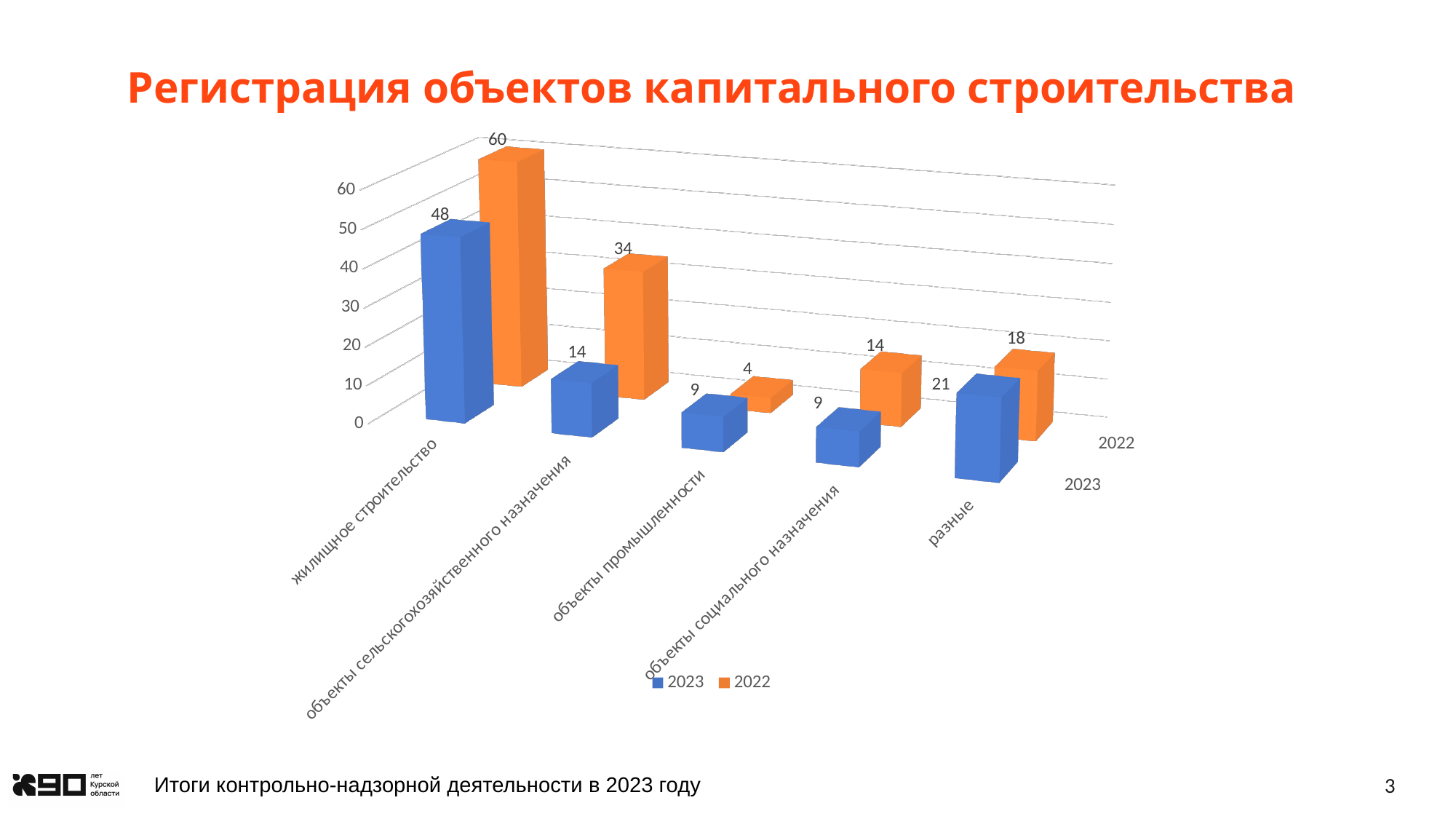
For разные, which series has the larger value, 2023 or 2022? 2023 What is the value for разные in the 2023 series? 21 What is the value for жилищное строительство in the 2023 series? 48 How many categories are shown on the x axis? 5 Which category has the highest value in the 2022 series? жилищное строительство Which category has the lowest value in the 2022 series? объекты промышленности What is the value for объекты промышленности in the 2022 series? 4 What kind of chart is shown on the slide? bar chart What is the difference between the 2022 and 2023 values for жилищное строительство? 12 How many series does the legend list? 2 What is the difference between the 2022 and 2023 values for объекты сельскогохозяйственного назначения? 20 What is the value for объекты сельскогохозяйственного назначения in the 2022 series? 34